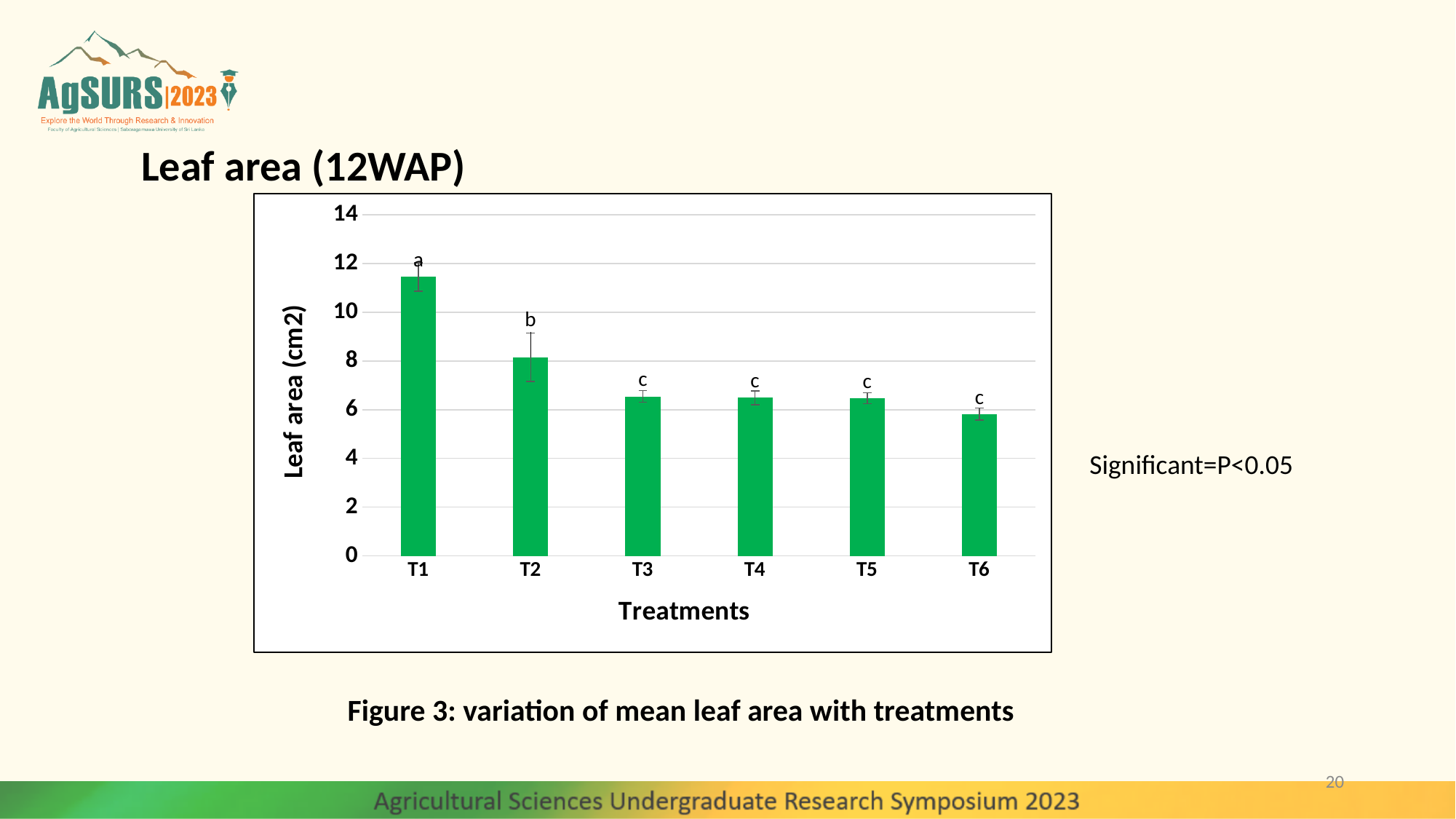
Is the value for T1 greater or less than 10? greater Which has a larger mean leaf area, T1 or T2? T1 How many treatments are plotted on the x axis? 6 Do the values generally rise or fall from T1 to T6? fall Which treatment has the lowest mean leaf area? T6 Which treatment has the highest mean leaf area? T1 Is the value for T2 greater or less than 10? less Is the value for T3 greater or less than 6? greater Which has a larger mean leaf area, T2 or T6? T2 What is the label on the y axis of the chart? Leaf area (cm2) What kind of chart is shown on the slide? bar chart